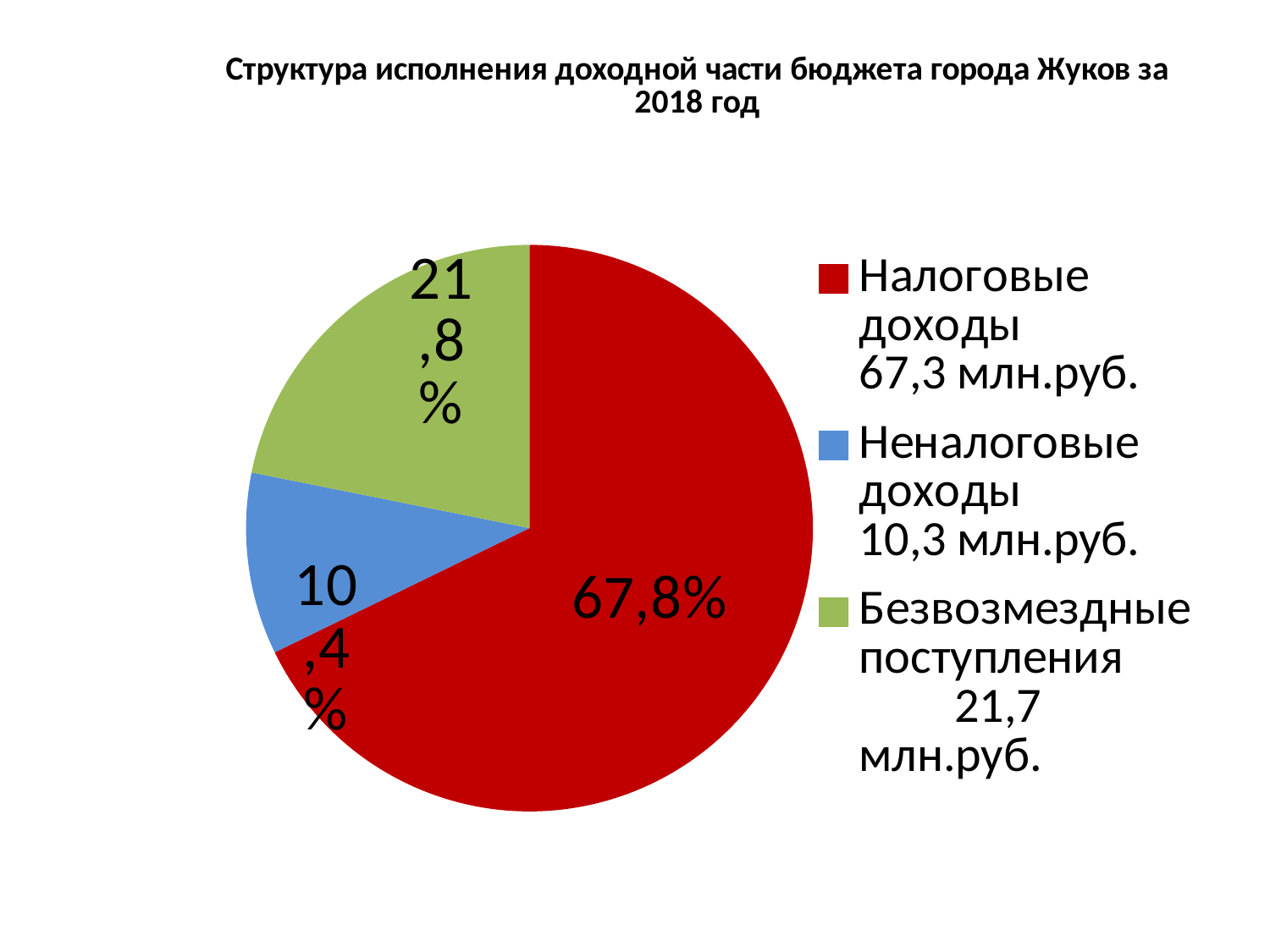
What share of the pie does Налоговые доходы take? 67,8% How many entries does the legend list? 3 Which slice is larger: Безвозмездные поступления or Неналоговые доходы? Безвозмездные поступления Which category has the largest slice of the pie? Налоговые доходы What kind of chart is shown on the slide? pie chart What is the difference in percentage points between the Налоговые доходы slice and the Безвозмездные поступления slice? 46 percentage points What share of the pie does Неналоговые доходы take? 10,4% Which category has the smallest slice of the pie? Неналоговые доходы What share of the pie does Безвозмездные поступления take? 21,8% What colour is the slice for Безвозмездные поступления? green How many slices does the pie chart have? 3 What amount in млн.руб. does the legend give for Неналоговые доходы? 10,3 млн.руб.